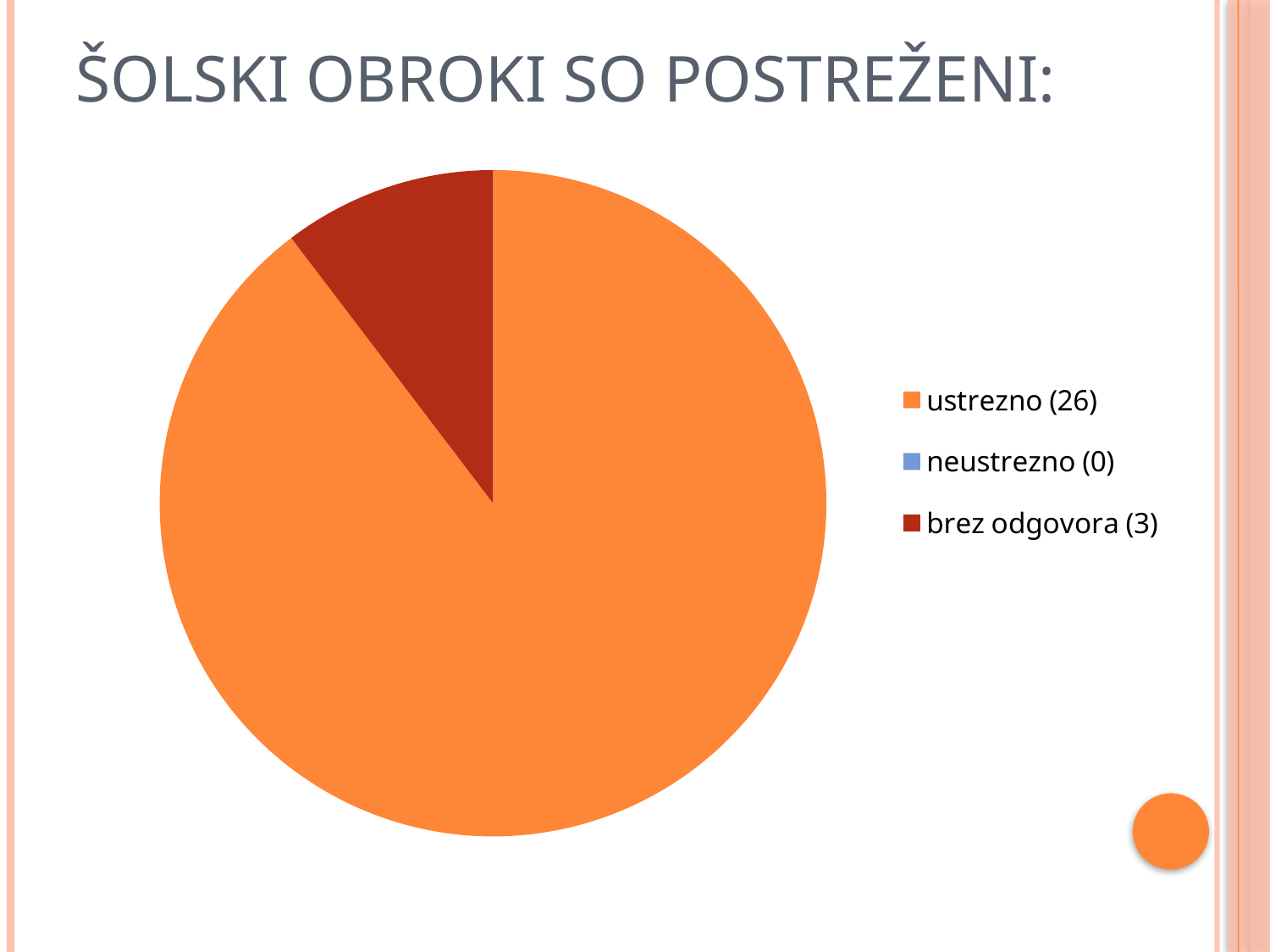
Which category has the smallest value in the pie chart? neustrezno What kind of chart is shown on the slide? pie chart What is the title of the slide containing the pie chart? ŠOLSKI OBROKI SO POSTREŽENI: What is the total of all values shown in the pie chart legend? 29 What is the value for "brez odgovora" in the pie chart? 3 What is the value for "ustrezno" in the pie chart? 26 What is the value for "neustrezno" in the pie chart? 0 Which is larger, the value for "brez odgovora" or the value for "neustrezno"? brez odgovora What is the difference between the values for "ustrezno" and "brez odgovora"? 23 How many categories does the legend of the pie chart list? 3 What colour is the slice for "brez odgovora" in the pie chart? dark red Which category has the largest slice of the pie chart? ustrezno